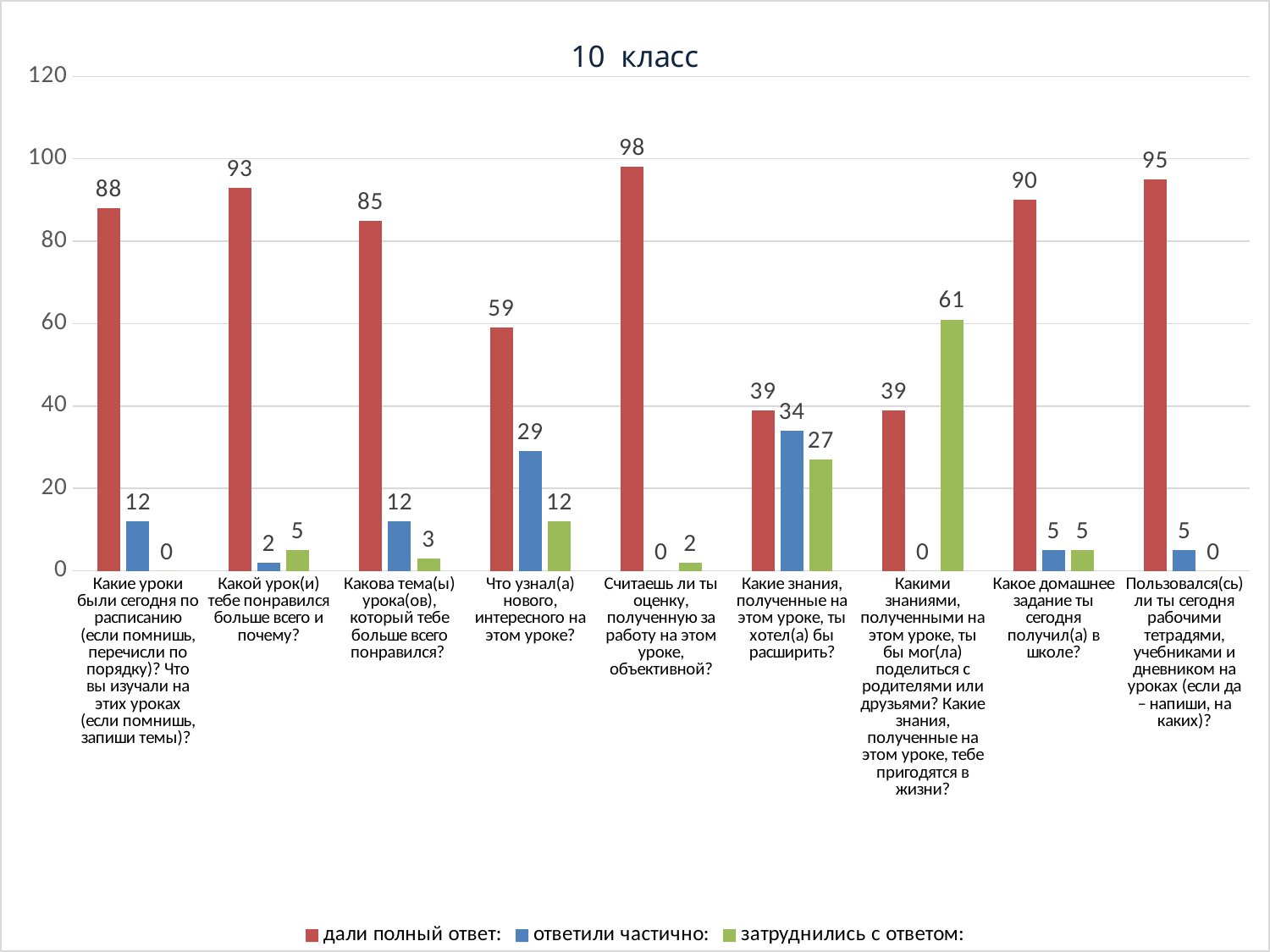
How many series does the legend list? 3 What is the value of "дали полный ответ:" for "Считаешь ли ты оценку, полученную за работу на этом уроке, объективной?"? 98 What is the value of "ответили частично:" for "Что узнал(а) нового, интересного на этом уроке?"? 29 How many question categories are shown on the x axis? 9 For "Какими знаниями, полученными на этом уроке, ты бы мог(ла) поделиться с родителями или друзьями?", which is larger: "дали полный ответ:" or "затруднились с ответом:"? затруднились с ответом: Which category has the highest value for "ответили частично:"? Какие знания, полученные на этом уроке, ты хотел(а) бы расширить? What type of chart is shown on the slide? bar chart What is the difference between "дали полный ответ:" and "ответили частично:" for "Какие знания, полученные на этом уроке, ты хотел(а) бы расширить?"? 5 What is the title of the chart? 10 класс What is the value of "затруднились с ответом:" for "Какое домашнее задание ты сегодня получил(а) в школе?"? 5 What is the value of "затруднились с ответом:" for "Какими знаниями, полученными на этом уроке, ты бы мог(ла) поделиться с родителями или друзьями?"? 61 Which category has the highest value for "дали полный ответ:"? Считаешь ли ты оценку, полученную за работу на этом уроке, объективной?